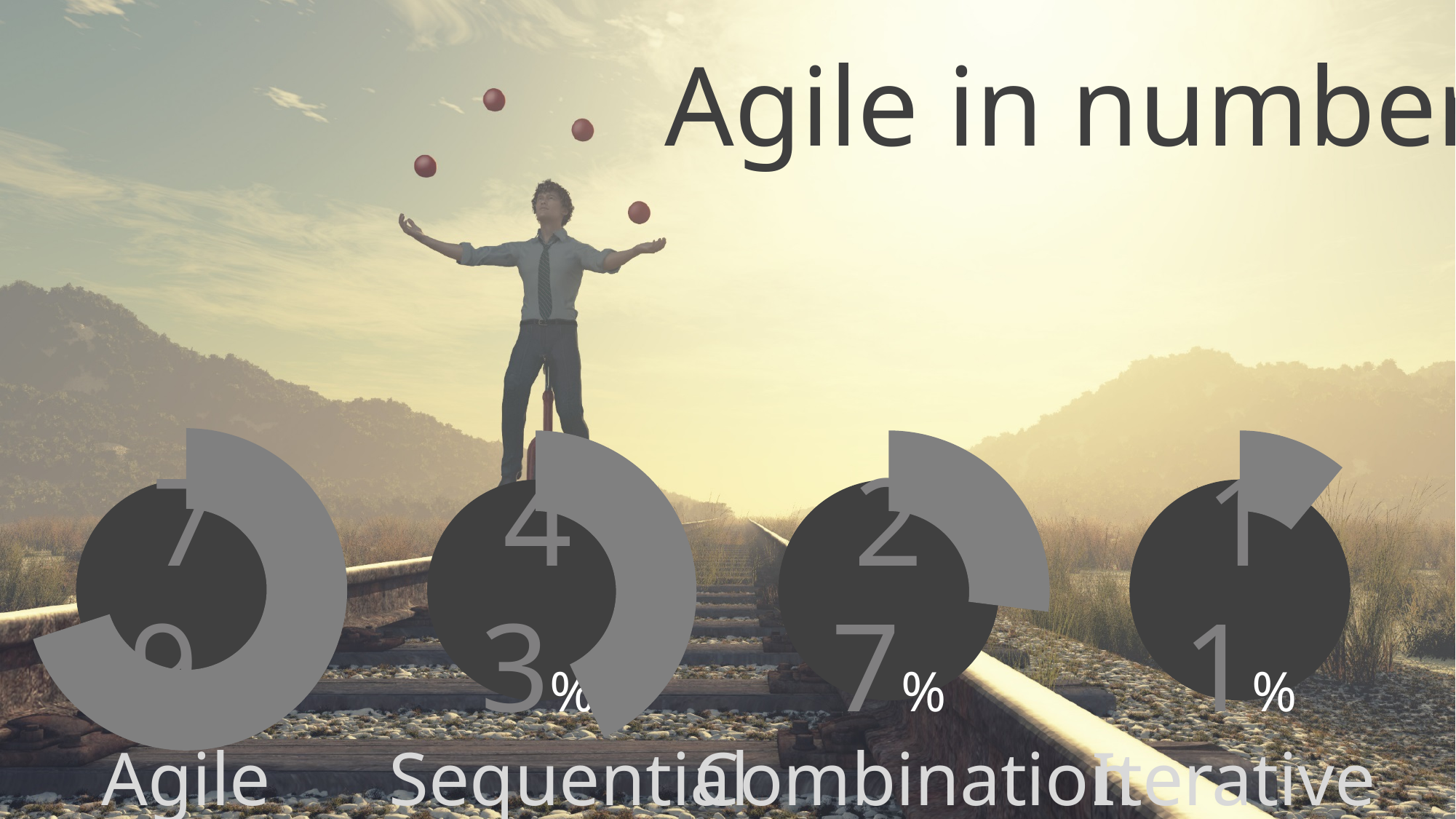
Which is larger, the Combination value or the Iterative value? Combination Which of the four charts shows the largest filled slice? Agile How many charts are shown on the slide? 4 What is the difference between the Combination value and the Iterative value? 16% What value is shown on the Combination chart? 27% What is the difference between the Sequential value and the Combination value? 16% What kind of chart is used for each of the four approaches? Doughnut chart Which is larger, the Sequential value or the Combination value? Sequential Which of the four charts shows the smallest value? Iterative What value is shown on the Sequential chart? 43% What value is shown on the Iterative chart? 11% What is the difference between the Sequential value and the Iterative value? 32%